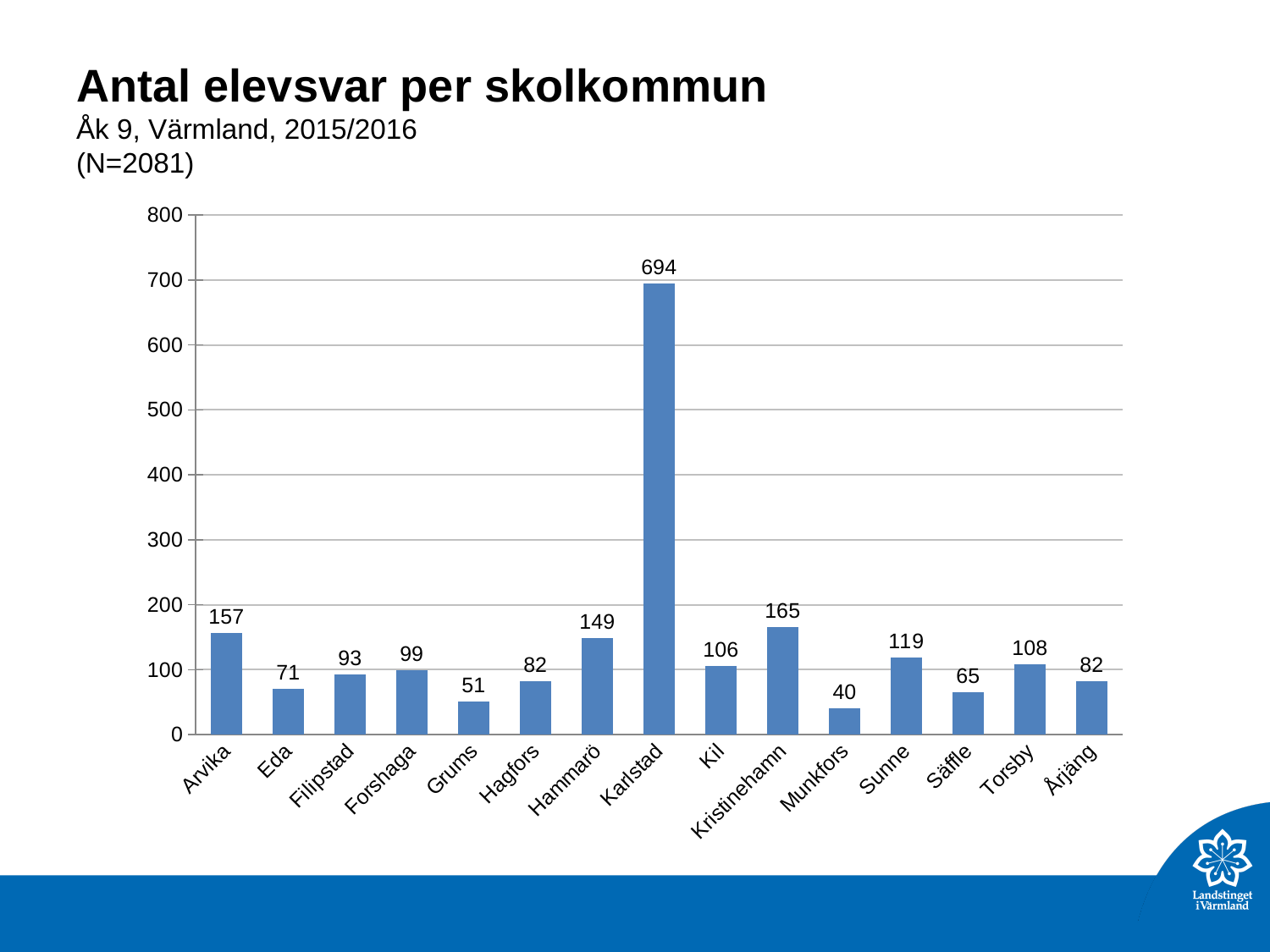
Which has a larger value, Hammarö or Sunne? Hammarö What is the difference between the values for Arvika and Eda? 86 What is the value for Karlstad? 694 What is the value for Munkfors? 40 Which municipality has the highest number of student responses? Karlstad What is the value for Kristinehamn? 165 Which municipality has the lowest number of student responses? Munkfors What is the total N stated in the subtitle? 2081 Is the value for Kil greater or less than 100? greater What kind of chart is shown on the slide? Bar chart How many municipalities are shown on the x axis? 15 What is the title of the chart on the slide? Antal elevsvar per skolkommun